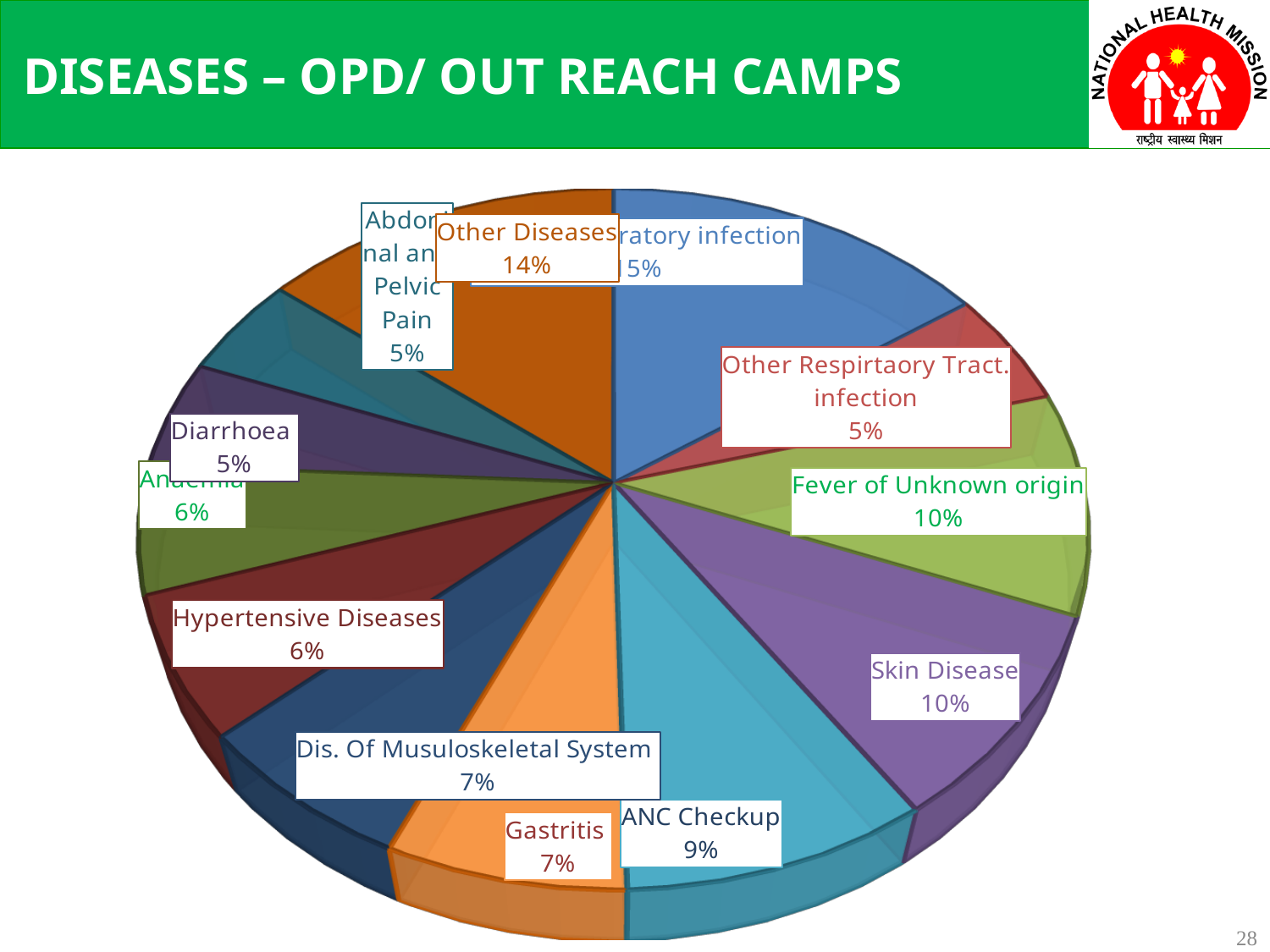
How many percentage points larger is the Other Diseases share than the ANC Checkup share? 5 percentage points What is the share for Diarrhoea? 5% What is the share for Fever of Unknown origin? 10% Which has the larger share, Fever of Unknown origin or Gastritis? Fever of Unknown origin What kind of chart is shown on the slide? Pie chart What is the title of the slide containing the pie chart? DISEASES – OPD/ OUT REACH CAMPS What is the share for Skin Disease? 10% What percentage share does Other Diseases have in the pie chart? 14% What is the share for Dis. Of Musuloskeletal System? 7% What percentage is shown for Hypertensive Diseases? 6% What percentage is shown for Gastritis? 7% What percentage is shown for ANC Checkup? 9%